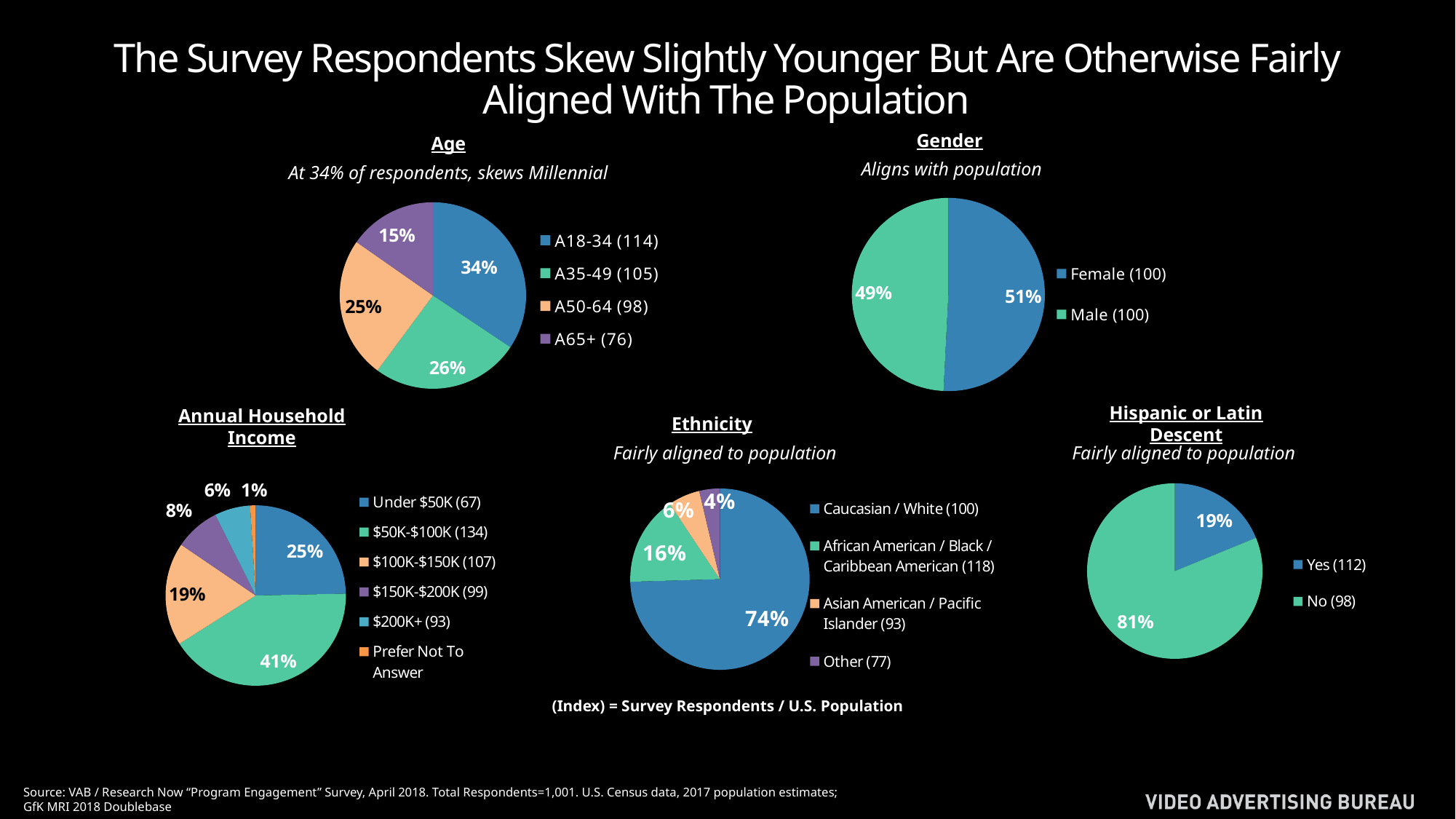
In the Annual Household Income pie chart, what is the difference between the $50K-$100K share and the Under $50K share? 16 percentage points In the Hispanic or Latin Descent pie chart, what share of respondents answered No? 81% In the Age pie chart, what share of respondents are A18-34? 34% In the Age pie chart, which age group has the smallest share? A65+ In the Age chart legend, what index value is shown for A18-34? 114 In the Annual Household Income pie chart, what share of respondents earn $50K-$100K? 41% In the Ethnicity pie chart, what share of respondents are Caucasian / White? 74% In the Age pie chart, which age group has the largest share? A18-34 In the Ethnicity pie chart, which is larger: African American / Black / Caribbean American or Asian American / Pacific Islander? African American / Black / Caribbean American In the Gender pie chart, what share of respondents are Female? 51% How many categories does the Annual Household Income pie chart show? 6 What type of chart is used for the Gender breakdown? Pie chart